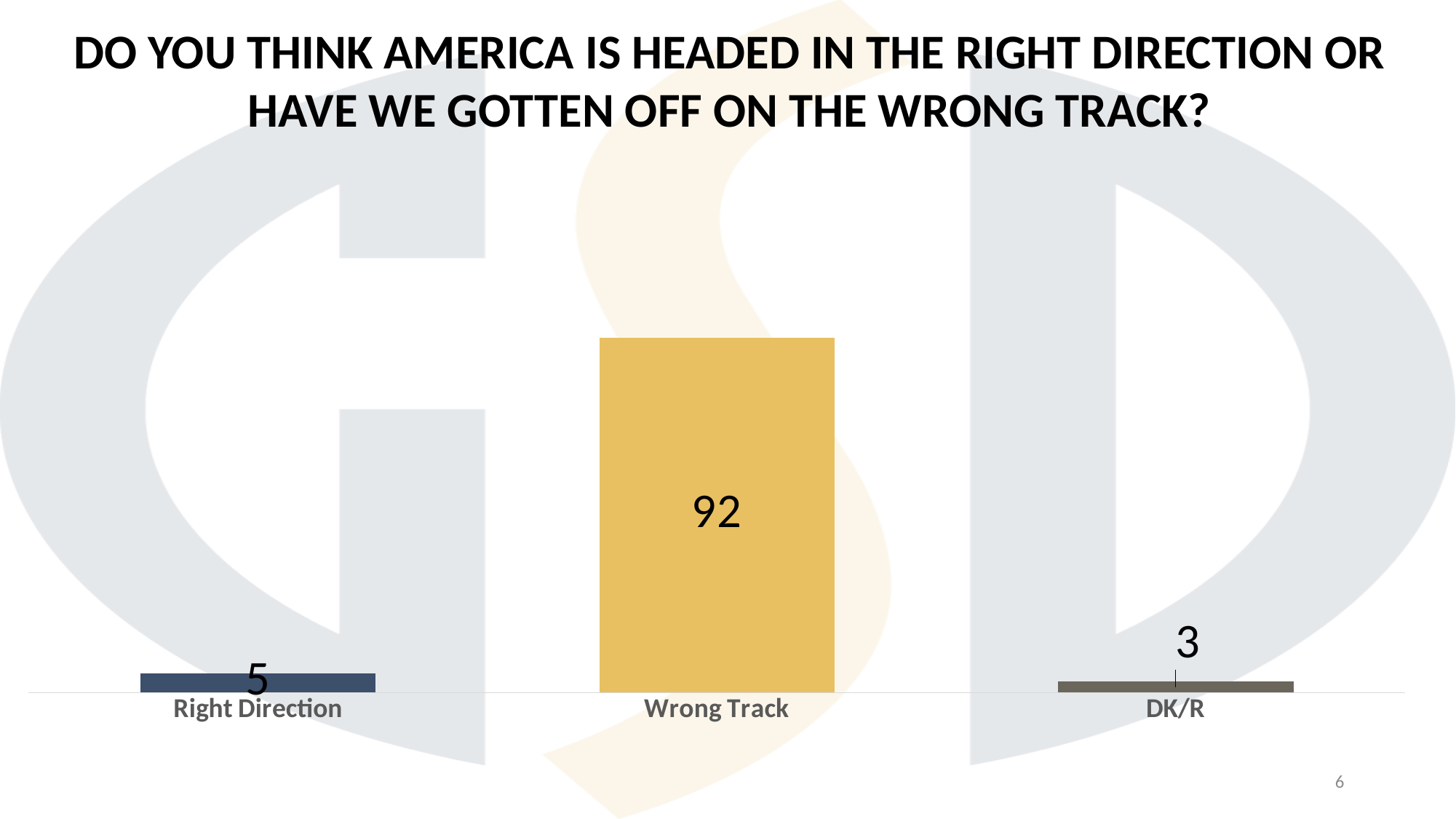
What is the title of the chart? Do you think America is headed in the right direction or have we gotten off on the wrong track? What is the value for Wrong Track? 92 What is the value for Right Direction? 5 What is the difference between the values for Wrong Track and Right Direction? 87 What is the value for DK/R? 3 Which category has the highest value? Wrong Track What kind of chart is shown on the slide? Bar chart Which category has the lowest value? DK/R Which is larger, the value for Right Direction or the value for DK/R? Right Direction What is the difference between the values for Right Direction and DK/R? 2 How many categories are shown in the chart? 3 What colour is the bar for Wrong Track? Yellow